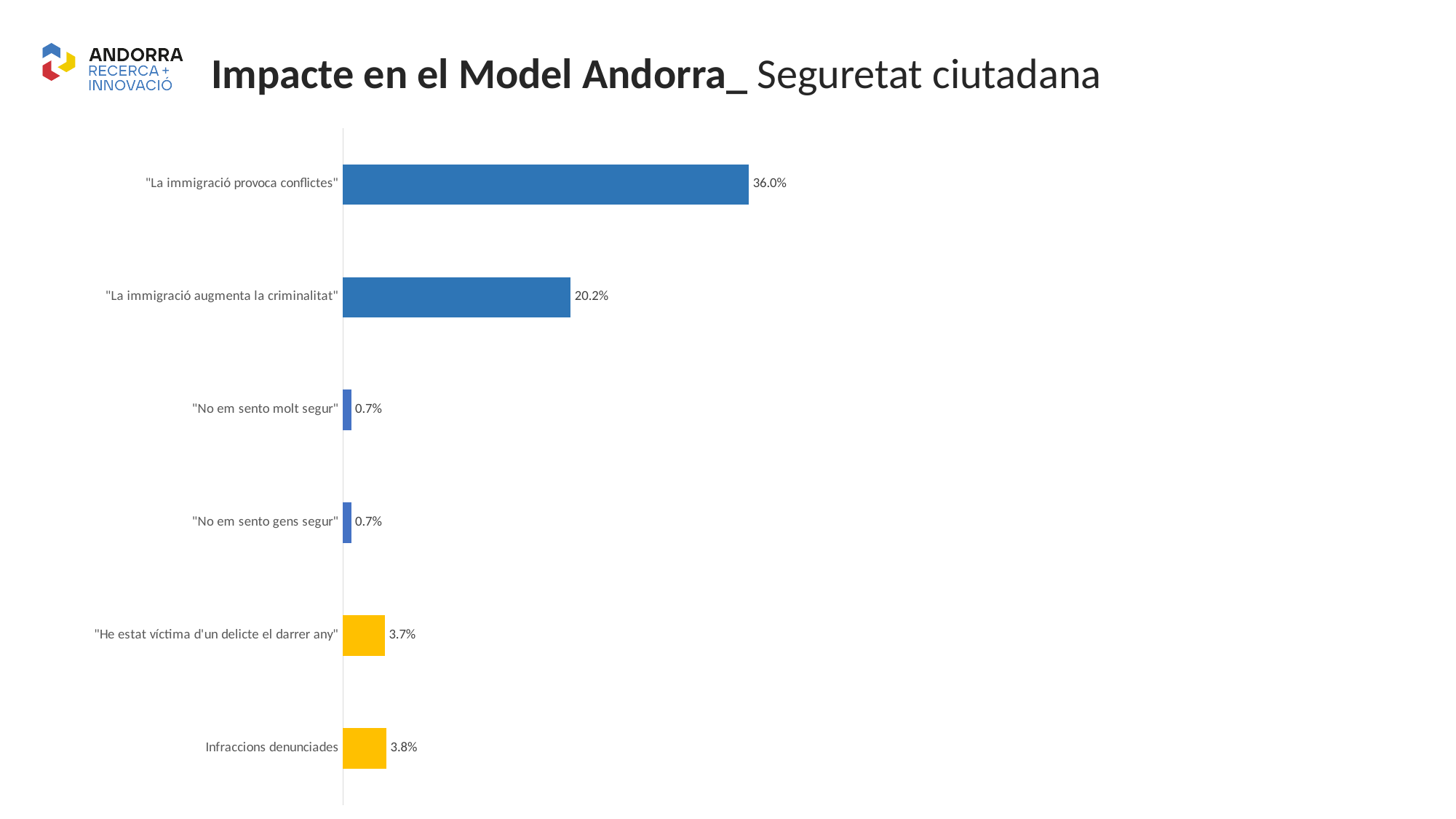
What kind of chart is shown on the slide? Bar chart Which category has the highest value? "La immigració provoca conflictes" What is the difference between the values for "Infraccions denunciades" and "He estat víctima d'un delicte el darrer any"? 0.1% What is the value for "La immigració provoca conflictes"? 36.0% What is the value for "La immigració augmenta la criminalitat"? 20.2% Which is larger, the value for "La immigració provoca conflictes" or the value for "La immigració augmenta la criminalitat"? "La immigració provoca conflictes" What is the value for "No em sento gens segur"? 0.7% How many categories are shown in the chart? 6 What is the value for "He estat víctima d'un delicte el darrer any"? 3.7% What is the difference between the values for "La immigració provoca conflictes" and "La immigració augmenta la criminalitat"? 15.8% What colour is the bar for "Infraccions denunciades"? Yellow What is the value for "Infraccions denunciades"? 3.8%